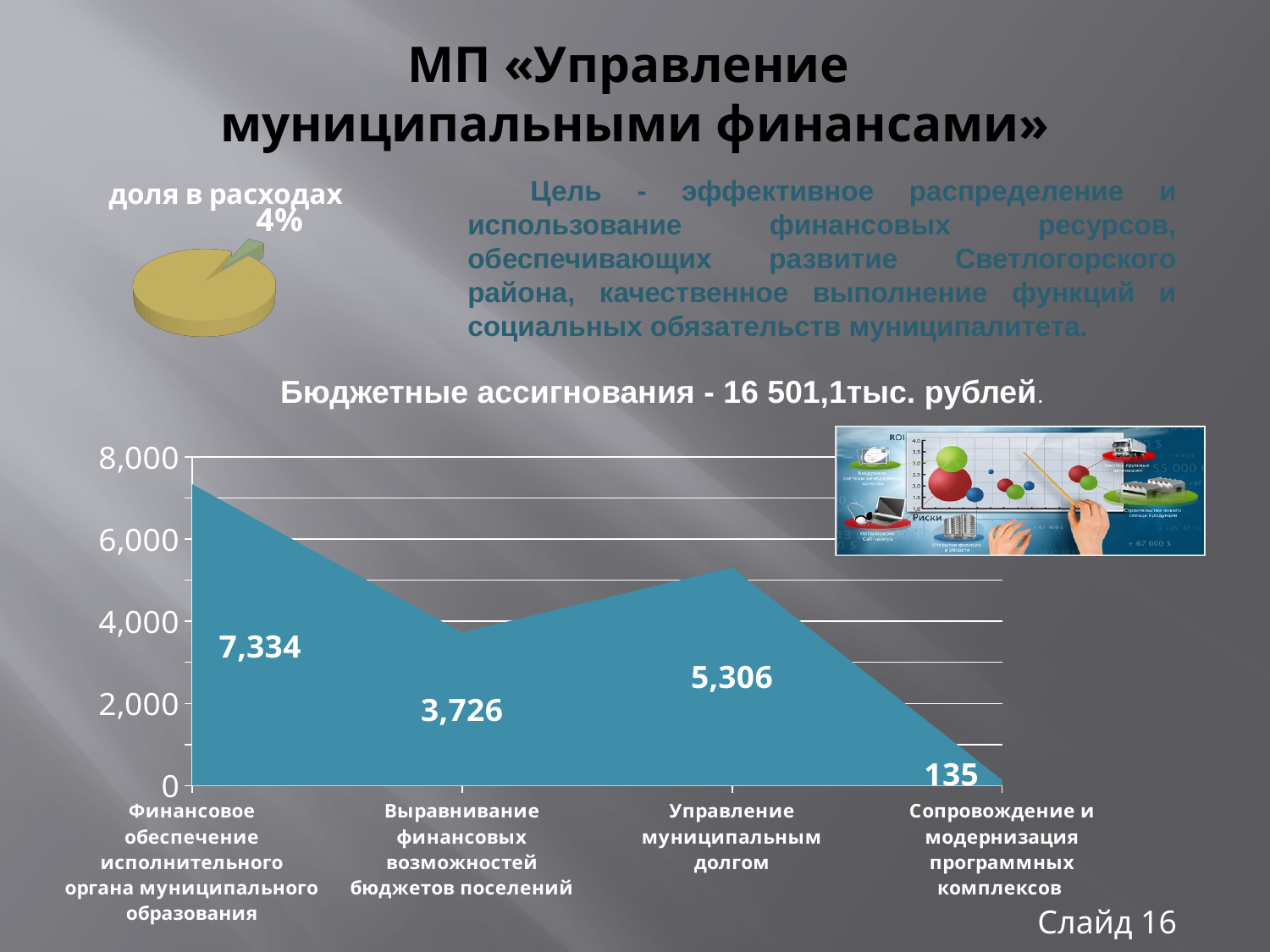
What kind of chart is the large chart at the bottom of the slide? area chart In the bottom area chart, which category has the highest value? Финансовое обеспечение исполнительного органа муниципального образования In the bottom area chart, which category has the lowest value? Сопровождение и модернизация программных комплексов In the bottom area chart, is the value for «Выравнивание финансовых возможностей бюджетов поселений» greater or less than 4,000? less In the pie chart titled «доля в расходах», what share is shown for the highlighted slice? 4% In the bottom area chart, what is the value for «Управление муниципальным долгом»? 5,306 In the bottom area chart, what is the value for «Сопровождение и модернизация программных комплексов»? 135 In the bottom area chart, which is larger: the value for «Управление муниципальным долгом» or for «Выравнивание финансовых возможностей бюджетов поселений»? Управление муниципальным долгом How many categories are shown on the x axis of the bottom area chart? 4 In the bottom area chart, what is the value for «Финансовое обеспечение исполнительного органа муниципального образования»? 7,334 In the bottom area chart, what is the difference between the values for «Финансовое обеспечение исполнительного органа муниципального образования» and «Выравнивание финансовых возможностей бюджетов поселений»? 3,608 In the bottom area chart, what is the value for «Выравнивание финансовых возможностей бюджетов поселений»? 3,726